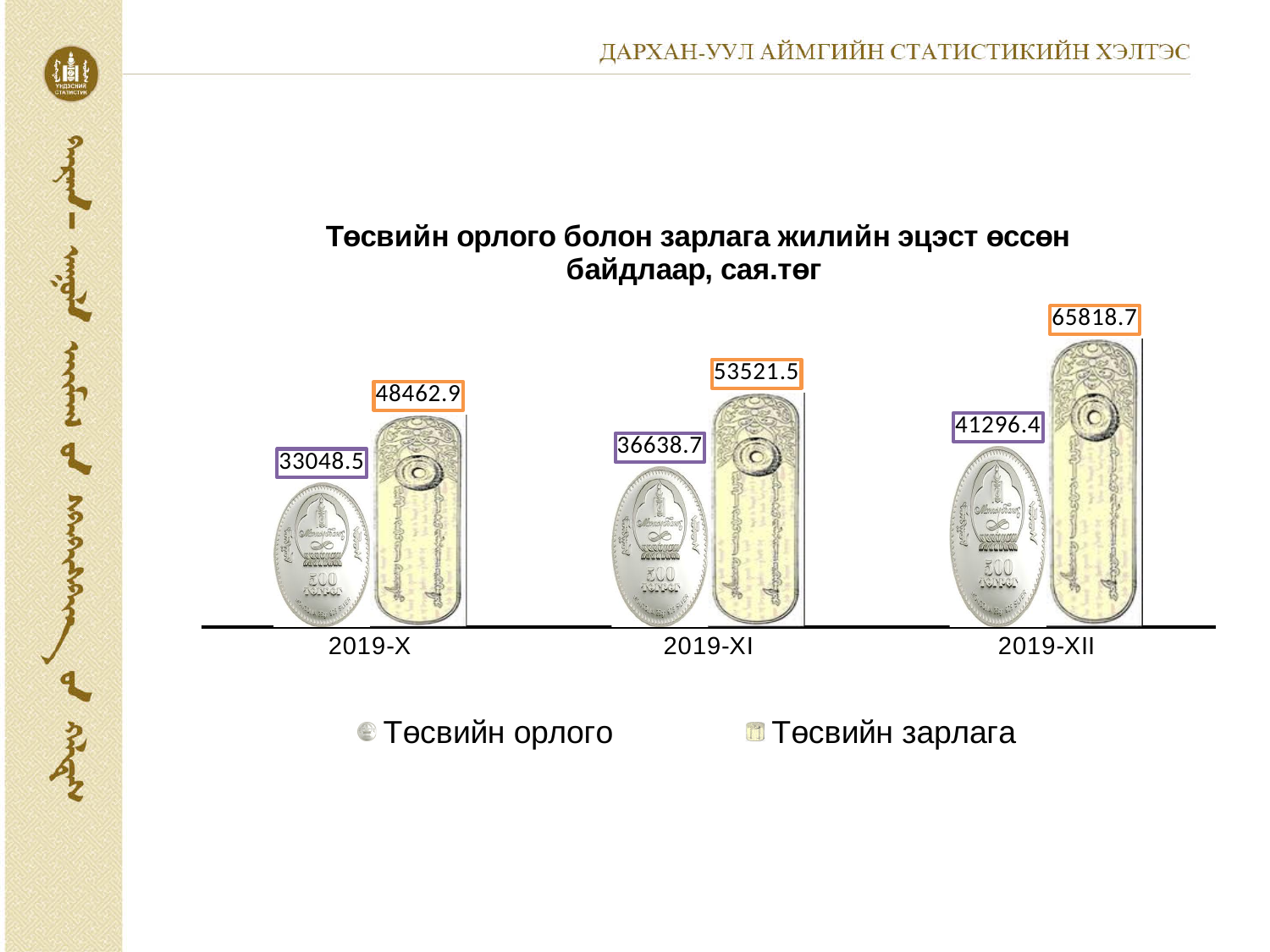
What is the value of Төсвийн зарлага for 2019-XII? 65818.7 Does Төсвийн зарлага rise or fall from 2019-X to 2019-XII? rise What is the value of Төсвийн орлого for 2019-XI? 36638.7 What is the difference between Төсвийн зарлага and Төсвийн орлого in 2019-XII? 24522.3 How many series does the legend list? 2 What is the value of Төсвийн зарлага for 2019-XI? 53521.5 How many periods are shown on the x axis? 3 In which period is Төсвийн орлого lowest? 2019-X What is the value of Төсвийн орлого for 2019-X? 33048.5 In which period is Төсвийн зарлага highest? 2019-XII Which is larger in 2019-X, Төсвийн орлого or Төсвийн зарлага? Төсвийн зарлага By how much did Төсвийн орлого increase from 2019-X to 2019-XII? 8247.9